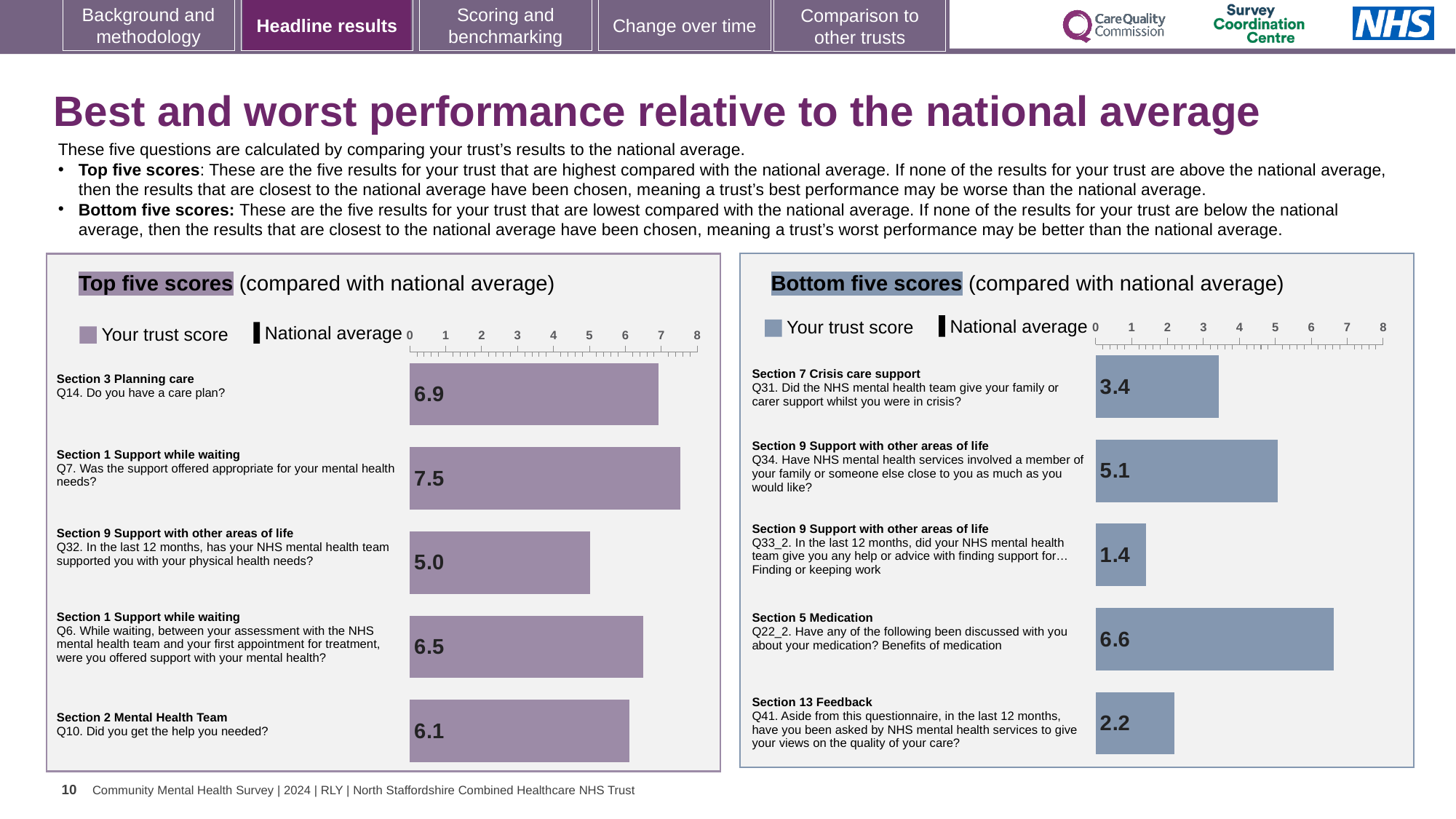
In the 'Top five scores' chart, what is the trust score for Q7. Was the support offered appropriate for your mental health needs? 7.5 In the 'Bottom five scores' chart, which has the larger trust score: Q34 or Q31? Q34 In the 'Bottom five scores' chart, what is the trust score for Q31. Did the NHS mental health team give your family or carer support whilst you were in crisis? 3.4 In the 'Top five scores' chart, which question has the lowest trust score? Q32. In the last 12 months, has your NHS mental health team supported you with your physical health needs? How many questions are plotted in the 'Bottom five scores' chart? 5 In the 'Top five scores' chart, which question has the highest trust score? Q7. Was the support offered appropriate for your mental health needs? In the 'Top five scores' chart, what is the trust score for Q14. Do you have a care plan? 6.9 In the 'Top five scores' chart, what is the difference between the trust scores for Q7 and Q10? 1.4 In the 'Bottom five scores' chart, which question has the lowest trust score? Q33_2. In the last 12 months, did your NHS mental health team give you any help or advice with finding support for… Finding or keeping work In the 'Bottom five scores' chart, which question has the highest trust score? Q22_2. Have any of the following been discussed with you about your medication? Benefits of medication In the 'Bottom five scores' chart, what is the trust score for Q41 about being asked to give your views on the quality of your care? 2.2 What type of chart is the 'Top five scores' chart? Bar chart